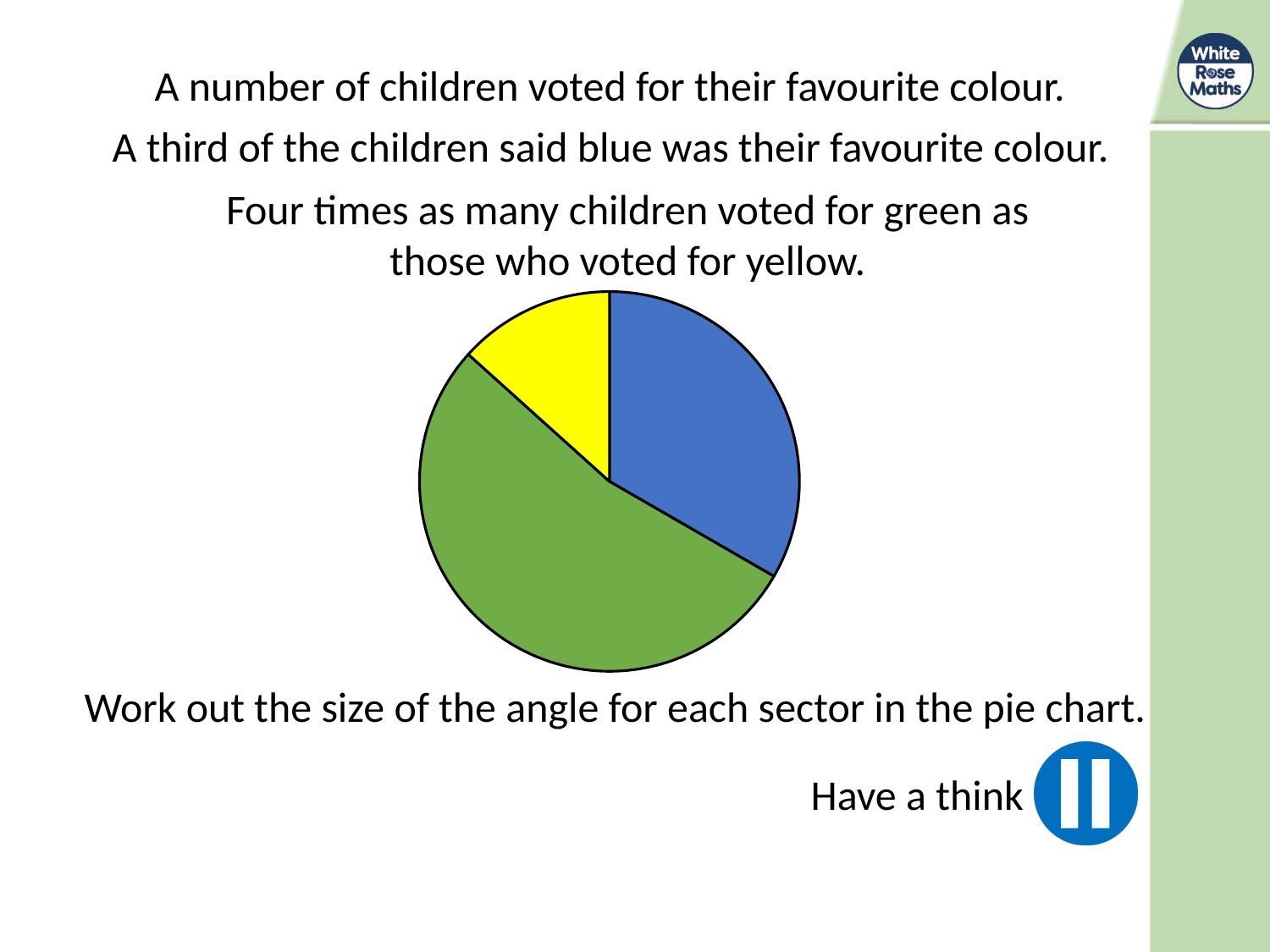
How many sectors does the pie chart have? 3 Which colour has the largest sector in the pie chart? green According to the slide, how many times as many children voted for green as for yellow? four times Which three colours appear as sectors in the pie chart? blue, green and yellow Which sector is larger, blue or yellow? blue According to the slide, what fraction of the children said blue was their favourite colour? a third What kind of chart is shown on the slide? pie chart Which sector is larger, green or blue? green Which colour has the smallest sector in the pie chart? yellow